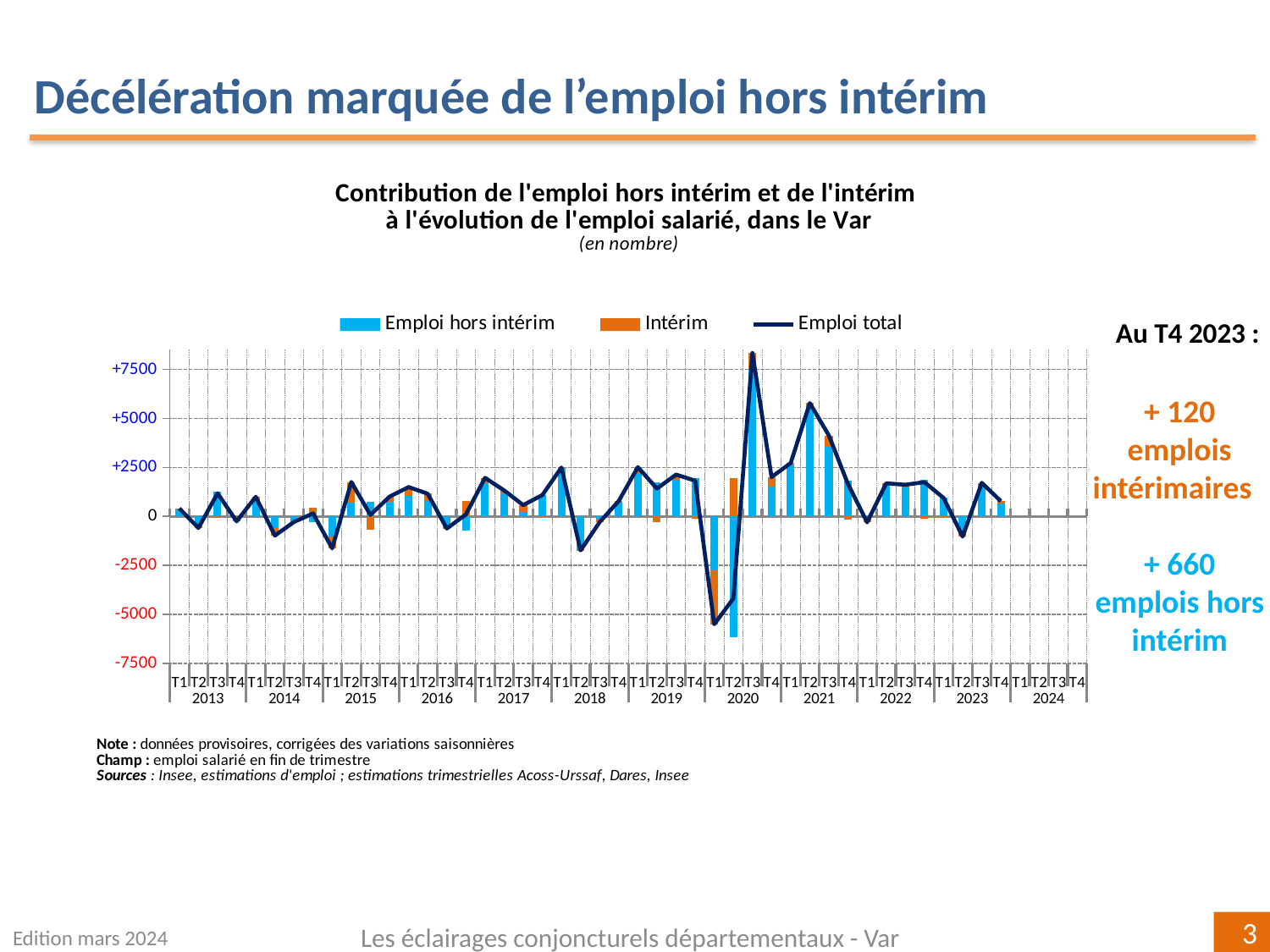
How many years are labelled along the x axis? 12 In which quarter does the Emploi total line reach its highest value? T3 2020 Is the value of Emploi total at T3 2020 greater or less than +7500? greater In which quarter does the Emploi total line reach its lowest value? T1 2020 What kind of chart is shown on the slide? Combined bar and line chart Is the value of Emploi total at T1 2020 greater or less than -2500? less Which is larger, the Emploi total value at T3 2020 or at T2 2021? T3 2020 According to the annotation, what is the value for Emploi hors intérim at T4 2023? + 660 How many series does the chart legend list? 3 Does the Emploi total line rise or fall between T3 2020 and T1 2021? fall What is the title of the chart? Contribution de l'emploi hors intérim et de l'intérim à l'évolution de l'emploi salarié, dans le Var According to the annotation, what is the value for Intérim at T4 2023? + 120